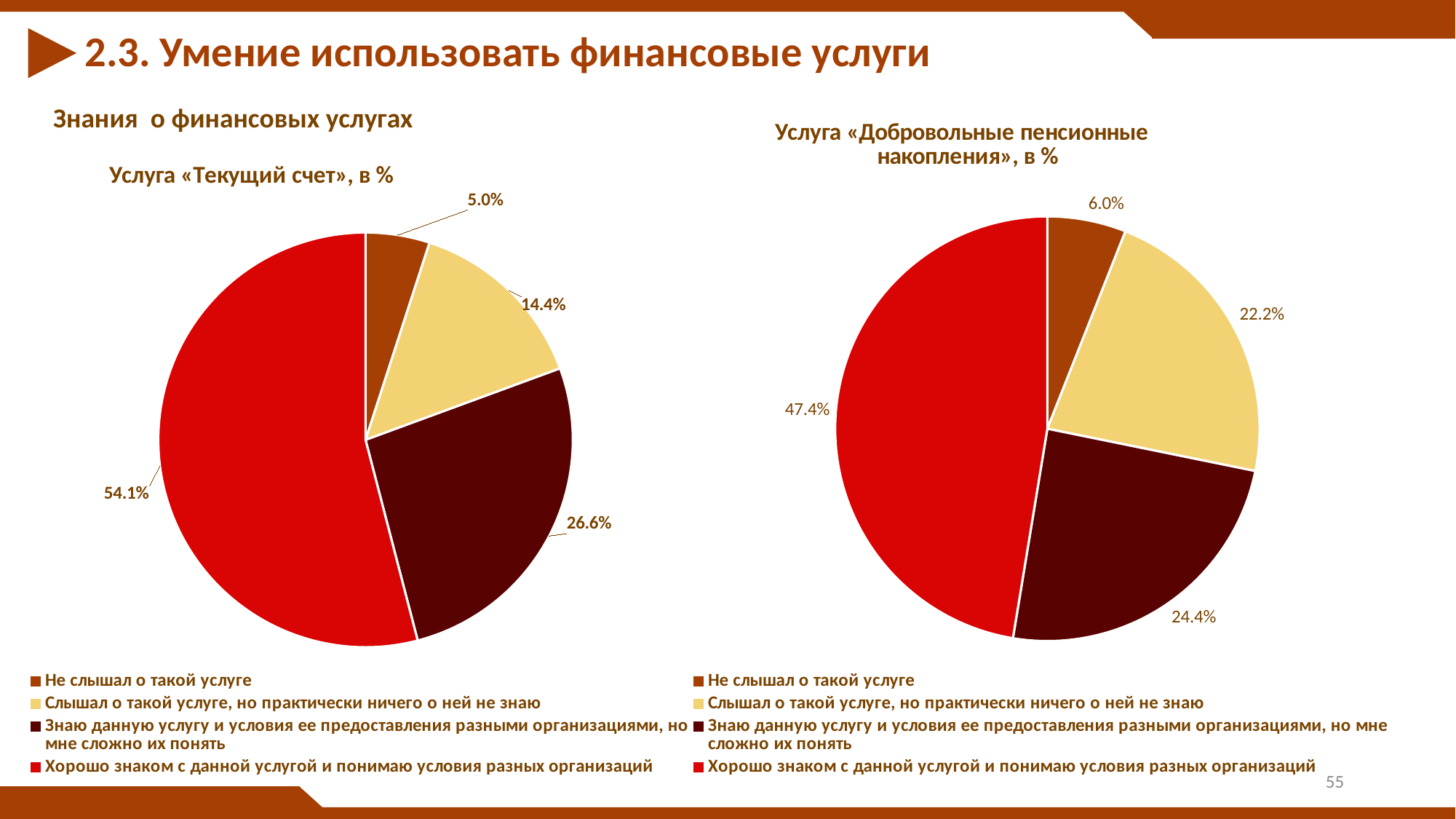
In the chart «Услуга «Текущий счет», в %», what is the value for «Не слышал о такой услуге»? 5.0% In the chart «Услуга «Добровольные пенсионные накопления», в %», which category has the smallest share? Не слышал о такой услуге What type of chart is «Услуга «Добровольные пенсионные накопления», в %»? Pie chart In the chart «Услуга «Добровольные пенсионные накопления», в %», what is the value for «Знаю данную услугу и условия ее предоставления разными организациями, но мне сложно их понять»? 24.4% In the chart «Услуга «Добровольные пенсионные накопления», в %», what is the value for «Слышал о такой услуге, но практически ничего о ней не знаю»? 22.2% In the chart «Услуга «Текущий счет», в %», what share of respondents answered «Хорошо знаком с данной услугой и понимаю условия разных организаций»? 54.1% In the chart «Услуга «Добровольные пенсионные накопления», в %», which is larger: «Слышал о такой услуге, но практически ничего о ней не знаю» or «Не слышал о такой услуге»? Слышал о такой услуге, но практически ничего о ней не знаю In the chart «Услуга «Текущий счет», в %», what colour is the slice for «Не слышал о такой услуге»? Brown How many categories does the chart «Услуга «Текущий счет», в %» show? 4 In the chart «Услуга «Текущий счет», в %», what is the difference between the shares for «Знаю данную услугу и условия ее предоставления разными организациями, но мне сложно их понять» and «Слышал о такой услуге, но практически ничего о ней не знаю»? 12.2% In the chart «Услуга «Текущий счет», в %», which category has the largest share? Хорошо знаком с данной услугой и понимаю условия разных организаций Which chart has the larger share for «Хорошо знаком с данной услугой и понимаю условия разных организаций»: «Услуга «Текущий счет», в %» or «Услуга «Добровольные пенсионные накопления», в %»? Услуга «Текущий счет», в %